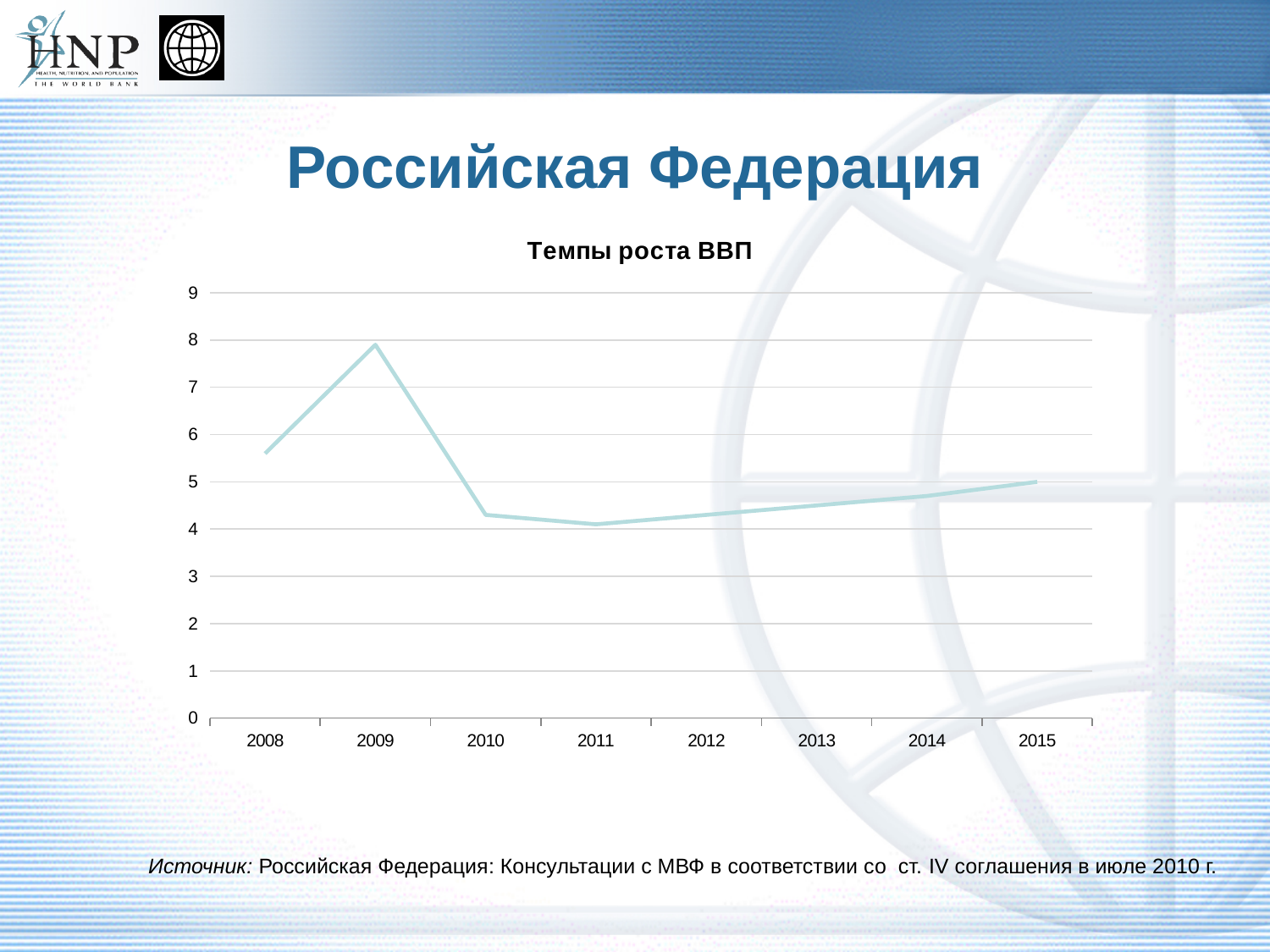
Which is larger, the value for 2008 or the value for 2010? 2008 Which year has the highest value on the chart? 2009 Do the values rise or fall from 2011 to 2015? rise What is the title of the chart? Темпы роста ВВП Is the value for 2010 greater or less than 5? less Is the value for 2009 greater or less than 7? greater Do the values rise or fall from 2009 to 2011? fall What kind of chart is shown on the slide? line chart How many years are plotted along the x axis? 8 Which year has the lowest value on the chart? 2011 Is the value for 2008 greater or less than 5? greater